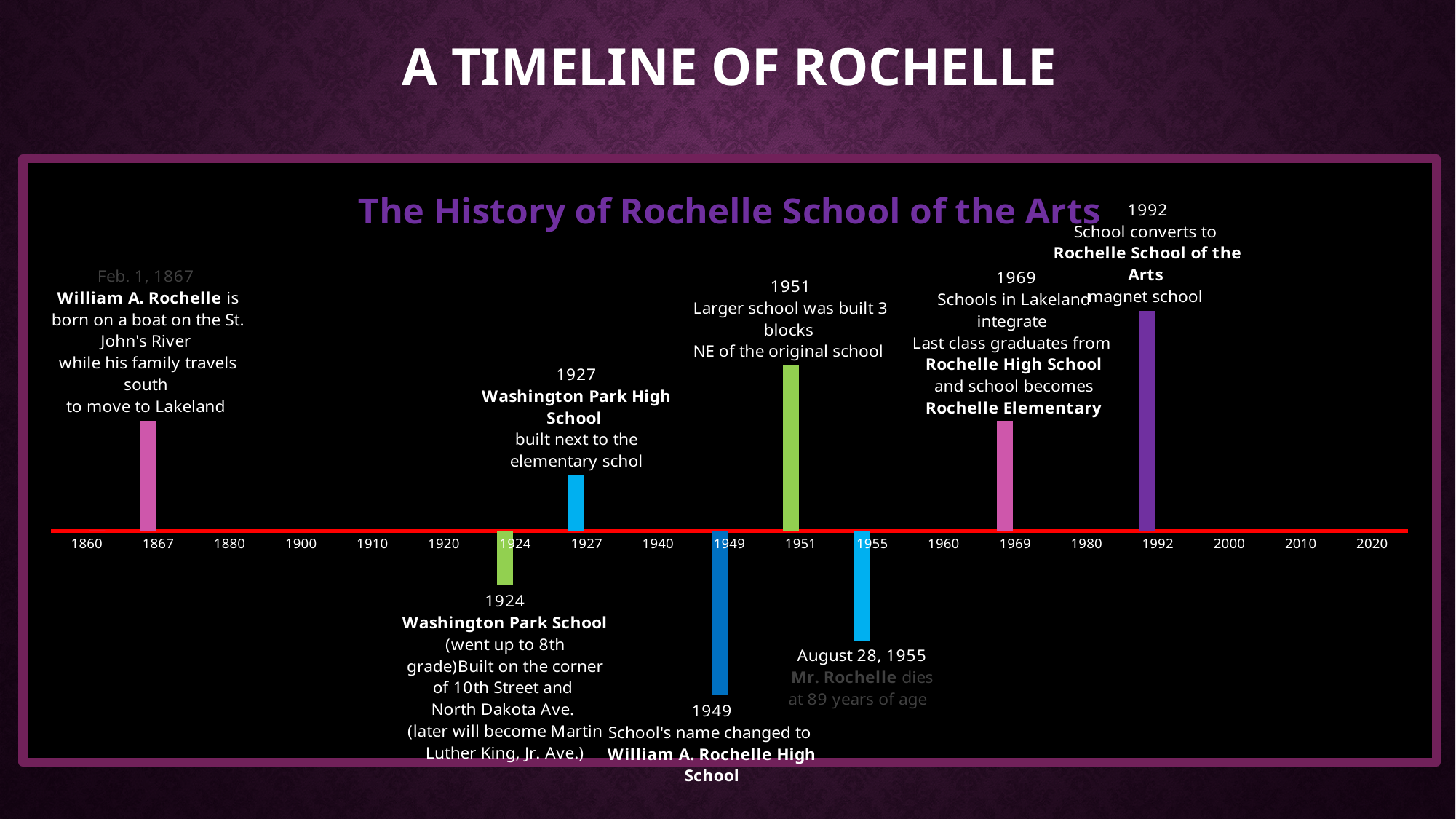
What kind of chart is shown on the slide? Timeline How many events are marked on the timeline? 8 How many years passed between the building of Washington Park School and Washington Park High School? 3 In what year was the school's name changed to William A. Rochelle High School? 1949 Which event comes later on the timeline: the larger school being built 3 blocks NE of the original school, or the school's name changing to William A. Rochelle High School? Larger school built 3 blocks NE of the original school (1951) What is the earliest date marked on the timeline? Feb. 1, 1867 In what year did the school convert to Rochelle School of the Arts magnet school? 1992 How many years passed between the last class graduating from Rochelle High School and the school converting to a magnet school? 23 What is the title of the chart? The History of Rochelle School of the Arts On what date did Mr. Rochelle die according to the timeline? August 28, 1955 In what year was Washington Park High School built next to the elementary school? 1927 What is the latest year marked on the timeline? 1992